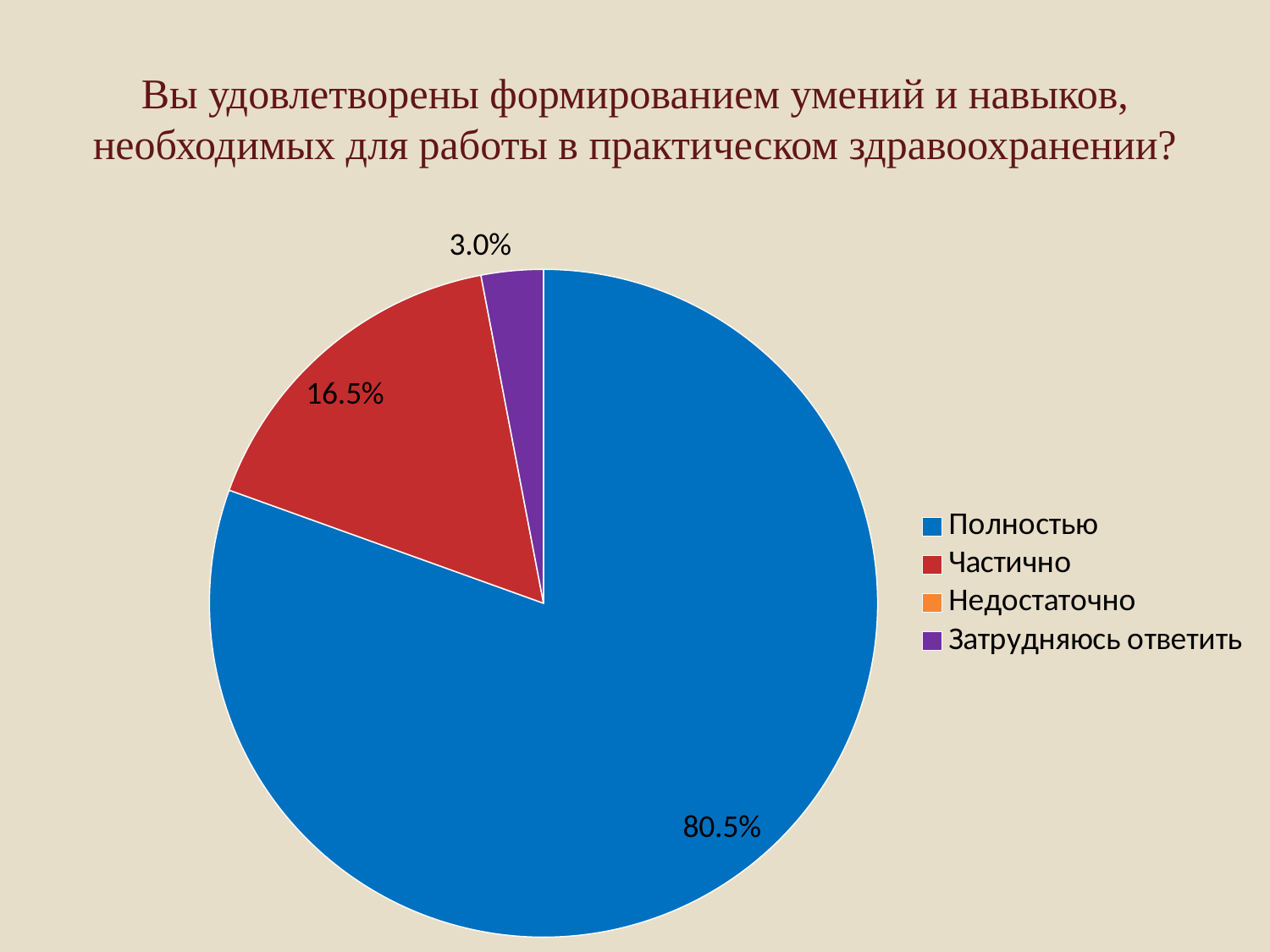
What is the difference in percentage points between "Частично" and "Затрудняюсь ответить"? 13.5% What share of the pie does "Затрудняюсь ответить" have? 3.0% What colour is the slice for "Полностью"? Blue What share of the pie does "Полностью" have? 80.5% What share of the pie does "Частично" have? 16.5% Which category has the largest slice of the pie? Полностью Which legend entry has no visible slice in the pie? Недостаточно Which of the labelled slices is the smallest? Затрудняюсь ответить What is the difference in percentage points between "Полностью" and "Частично"? 64.0% Which is larger, the slice for "Частично" or the slice for "Затрудняюсь ответить"? Частично What kind of chart is shown on the slide? Pie chart How many entries does the legend list? 4